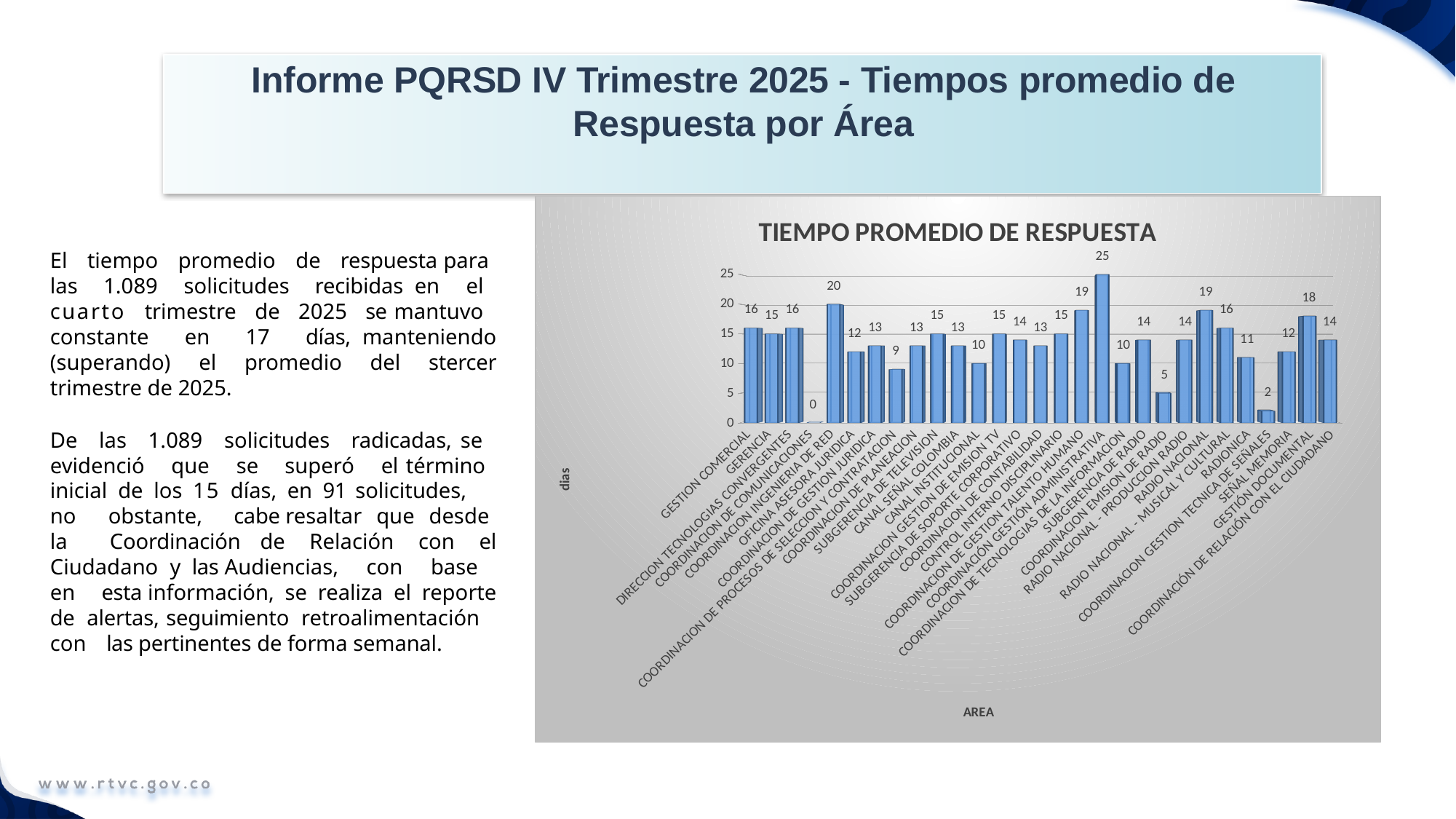
What is the average response time for GESTION COMERCIAL? 16 What is the title of the chart? TIEMPO PROMEDIO DE RESPUESTA What is the label of the vertical axis of the chart? días Which area has the lowest average response time in the chart? COORDINACION DE COMUNICACIONES What is the highest value shown in the chart? 25 What is the average response time for COORDINACION INGENIERIA DE RED? 20 What is the average response time for COORDINACION GESTION TECNICA DE SEÑALES? 2 What is the average response time for GESTIÓN DOCUMENTAL? 18 Which has a higher average response time, GERENCIA or COORDINACION INGENIERIA DE RED? COORDINACION INGENIERIA DE RED What is the difference between the average response time of COORDINACIÓN GESTIÓN ADMINISTRATIVA and COORDINACION EMISION DE RADIO? 20 Which area has the highest average response time in the chart? COORDINACIÓN GESTIÓN ADMINISTRATIVA What kind of chart is shown on the slide? Bar chart